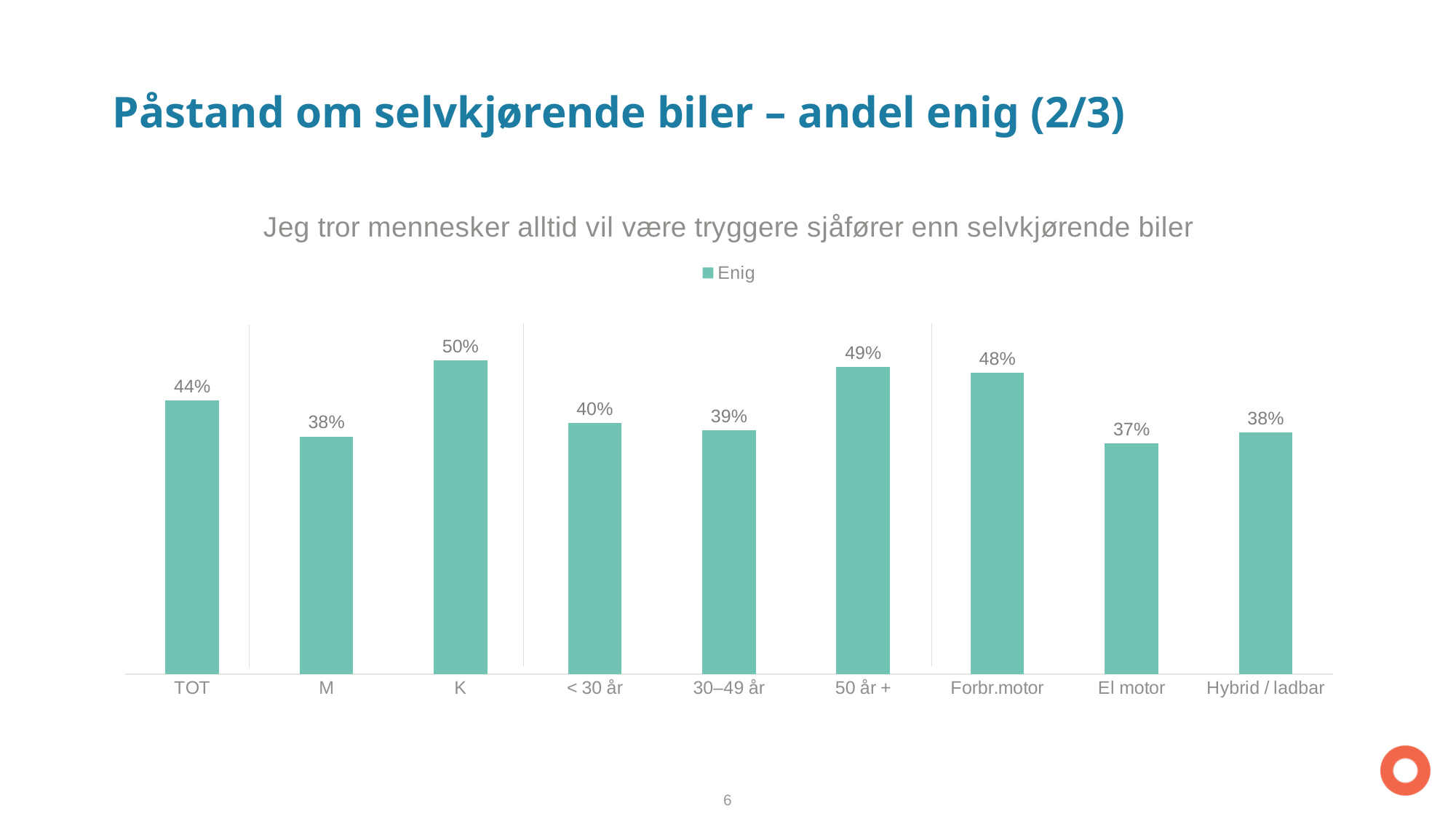
What is the value for 50 år +? 49% How many series does the legend list? 1 Which is larger, the value for Forbr.motor or the value for Hybrid / ladbar? Forbr.motor What is the difference between the values for 50 år + and < 30 år? 9% What is the difference between the values for K and M? 12% How many categories are shown on the x axis? 9 Which category has the lowest value? El motor What is the value for El motor? 37% What kind of chart is shown? Bar chart Which category has the highest value? K What is the value for K? 50% What is the value for TOT? 44%